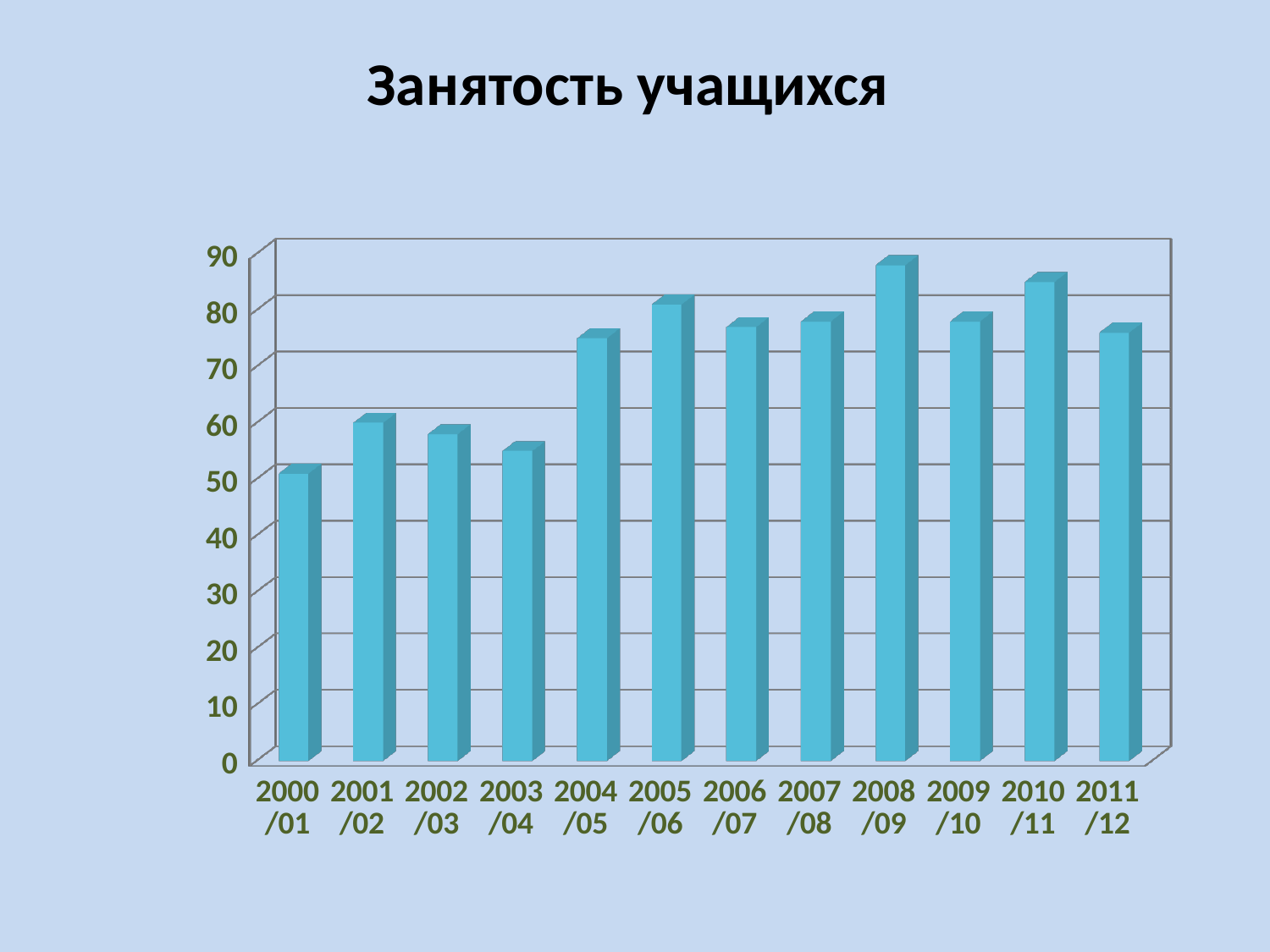
Which is larger, the value for 2005/06 or the value for 2004/05? 2005/06 Is the value for 2003/04 greater or less than 60? less Which school year has the highest value? 2008/09 Is the value for 2004/05 greater or less than 70? greater Is the value for 2011/12 greater or less than 80? less How many categories (school years) are shown on the x axis? 12 Do the values generally rise or fall from 2000/01 to 2005/06? rise Which is larger, the value for 2001/02 or the value for 2003/04? 2001/02 Which school year has the lowest value? 2000/01 What kind of chart is shown on the slide? bar chart What is the title of the chart? Занятость учащихся